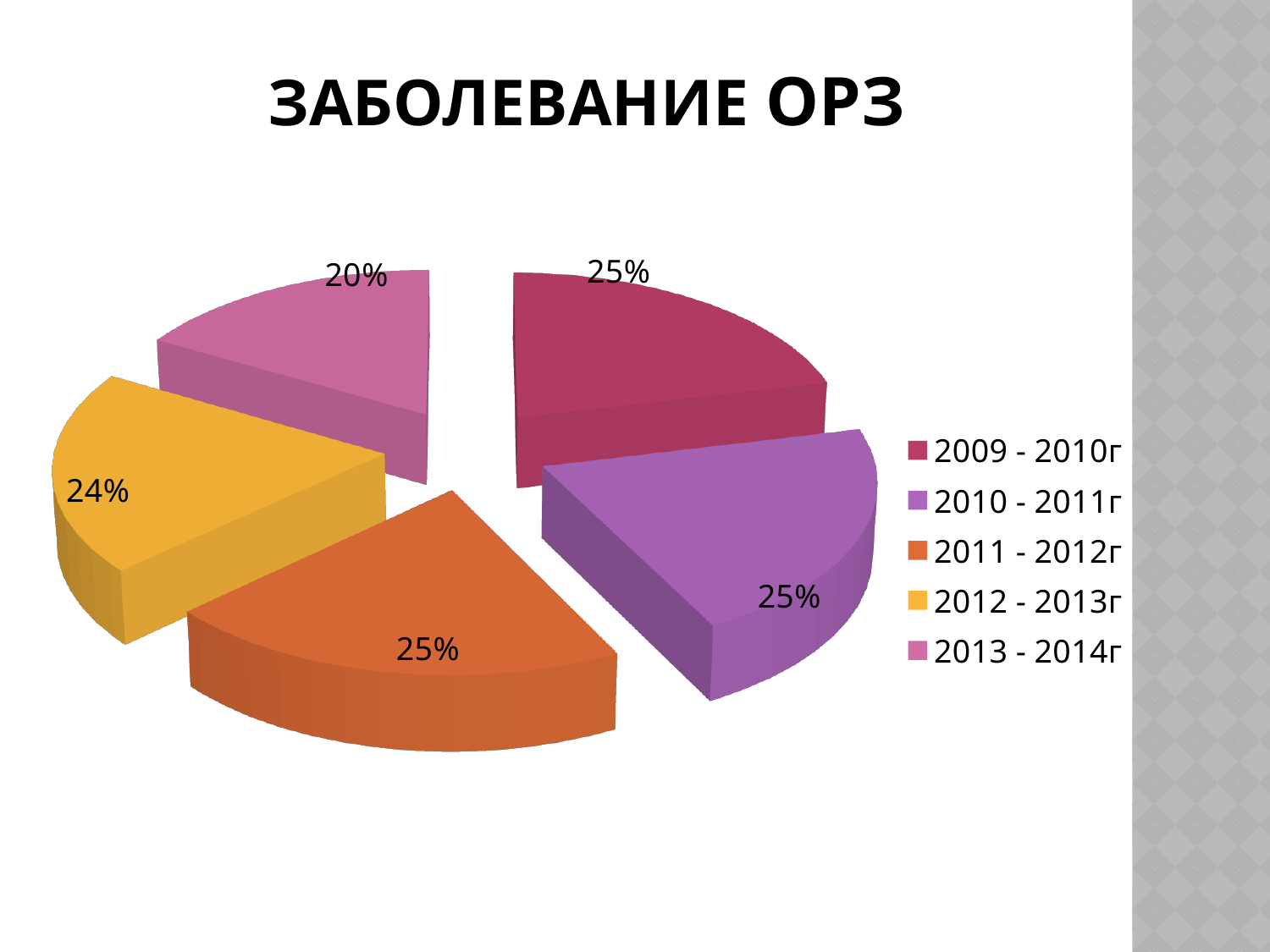
How many slices does the pie chart have? 5 Which period has the smallest slice of the pie? 2013 - 2014г What type of chart is shown on the slide? Pie chart What percentage is shown for the 2013 - 2014г slice? 20% What colour is the slice for 2012 - 2013г? Yellow Which is larger, the slice for 2012 - 2013г or the slice for 2013 - 2014г? 2012 - 2013г What percentage is shown for the 2011 - 2012г slice? 25% What percentage is shown for the 2009 - 2010г slice? 25% By how many percentage points does the 2012 - 2013г slice exceed the 2013 - 2014г slice? 4 percentage points What percentage is shown for the 2012 - 2013г slice? 24% What percentage is shown for the 2010 - 2011г slice? 25% What is the title of the slide? ЗАБОЛЕВАНИЕ ОРЗ